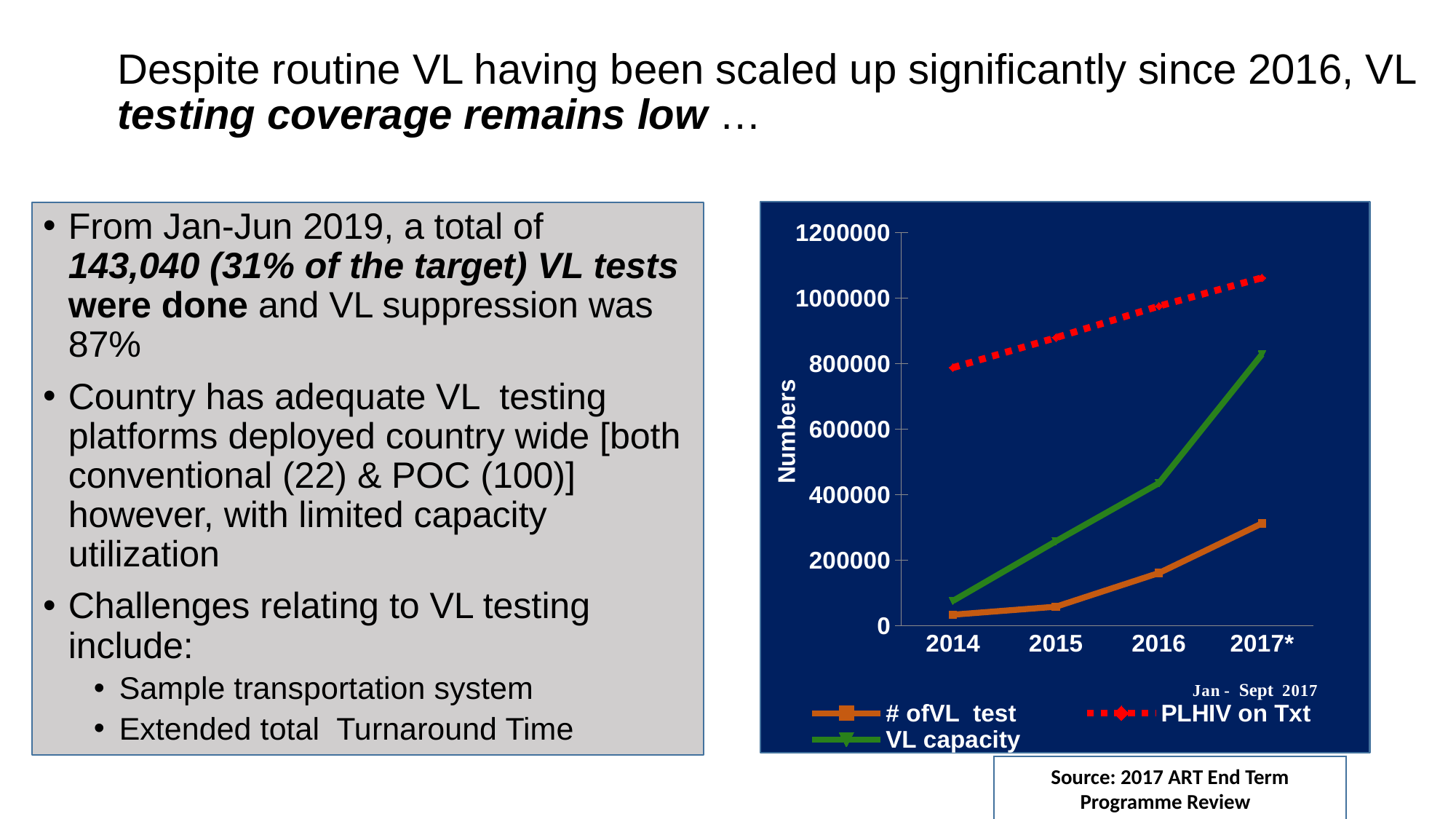
What kind of chart is shown on the slide? line chart How many years are shown on the x axis of the chart? 4 In which year is VL capacity highest? 2017* Is the value for PLHIV on Txt in 2017* greater or less than 1000000? greater In 2016, which is larger: VL capacity or # of VL test? VL capacity Does the VL capacity series rise or fall from 2014 to 2017*? rise Is the value for # of VL test in 2017* greater or less than 400000? less Does the # of VL test series rise or fall across the years shown? rise How many series does the chart legend list? 3 What is the label on the vertical axis of the chart? Numbers Is the value for VL capacity in 2017* greater or less than 600000? greater In which year is the # of VL test lowest? 2014